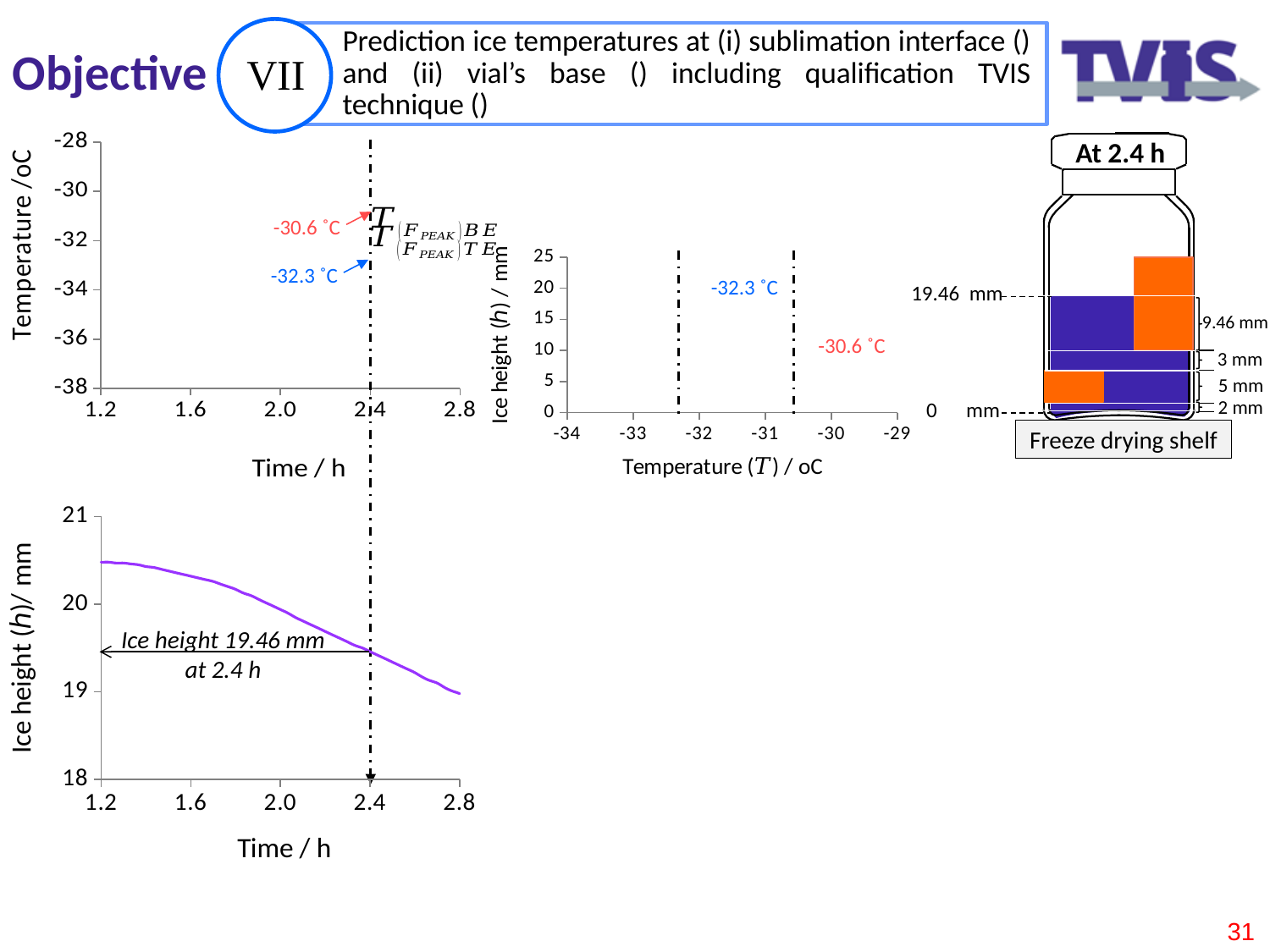
On the bottom-left chart (Ice height vs Time), does the ice height rise or fall as time increases? fall On the top-left chart (Temperature vs Time), what are the two temperatures annotated at 2.4 h? -30.6 °C and -32.3 °C On the bottom-left chart (Ice height vs Time), is the ice height at 1.2 h greater or less than 20 mm? greater On the bottom-left chart (Ice height vs Time), is the ice height at 2.8 h greater or less than 20 mm? less On the top-left chart (Temperature vs Time), which annotated temperature is higher, -30.6 °C or -32.3 °C? -30.6 °C On the top-left chart (Temperature vs Time), what is the difference between the annotated temperatures -30.6 °C and -32.3 °C? 1.7 °C On the bottom-left chart (Ice height vs Time), what is the ice height at 2.4 h? 19.46 mm On the bottom-left chart (Ice height vs Time), what is the label of the x axis? Time / h On the top-left chart (Temperature vs Time), what is the lowest value shown on the y axis? -38 On the bottom-left chart (Ice height vs Time), what kind of chart is it? line chart On the middle chart (Ice height vs Temperature), at which two temperatures are the vertical dashed lines drawn? -32.3 °C and -30.6 °C On the middle chart (Ice height vs Temperature), what is the maximum value shown on the y axis? 25